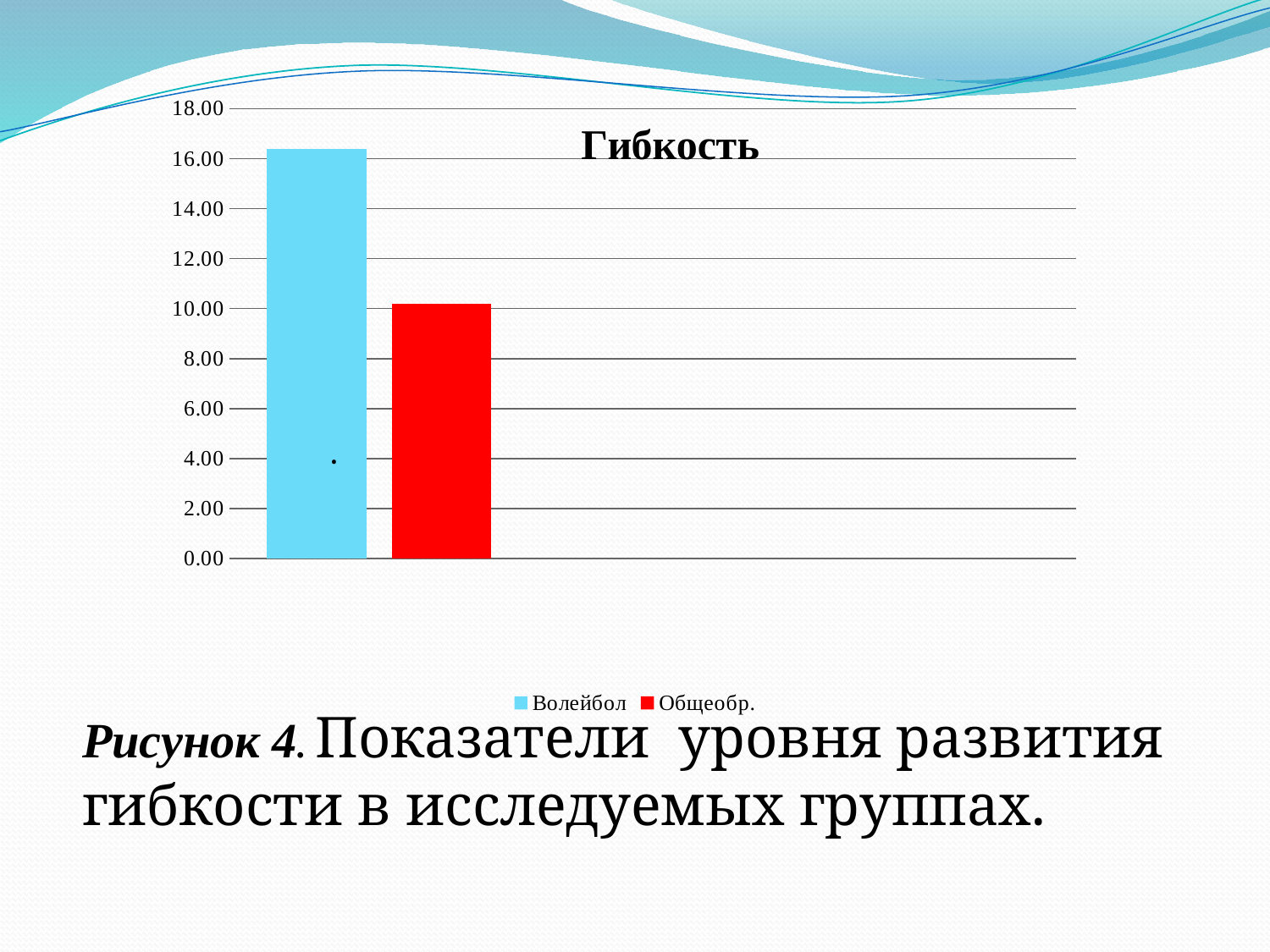
How many series does the legend list? 2 Which is larger, the value for Волейбол or the value for Общеобр.? Волейбол Which series has the lowest value in the chart? Общеобр. How many bars are plotted in the chart? 2 What kind of chart is shown on the slide? bar chart Is the value for Волейбол greater or less than 18.00? less What is the title of the chart? Гибкость Is the value for Общеобр. greater or less than 12.00? less What colour is the bar for Общеобр.? red Is the value for Волейбол greater or less than 14.00? greater Which series has the highest value in the chart? Волейбол